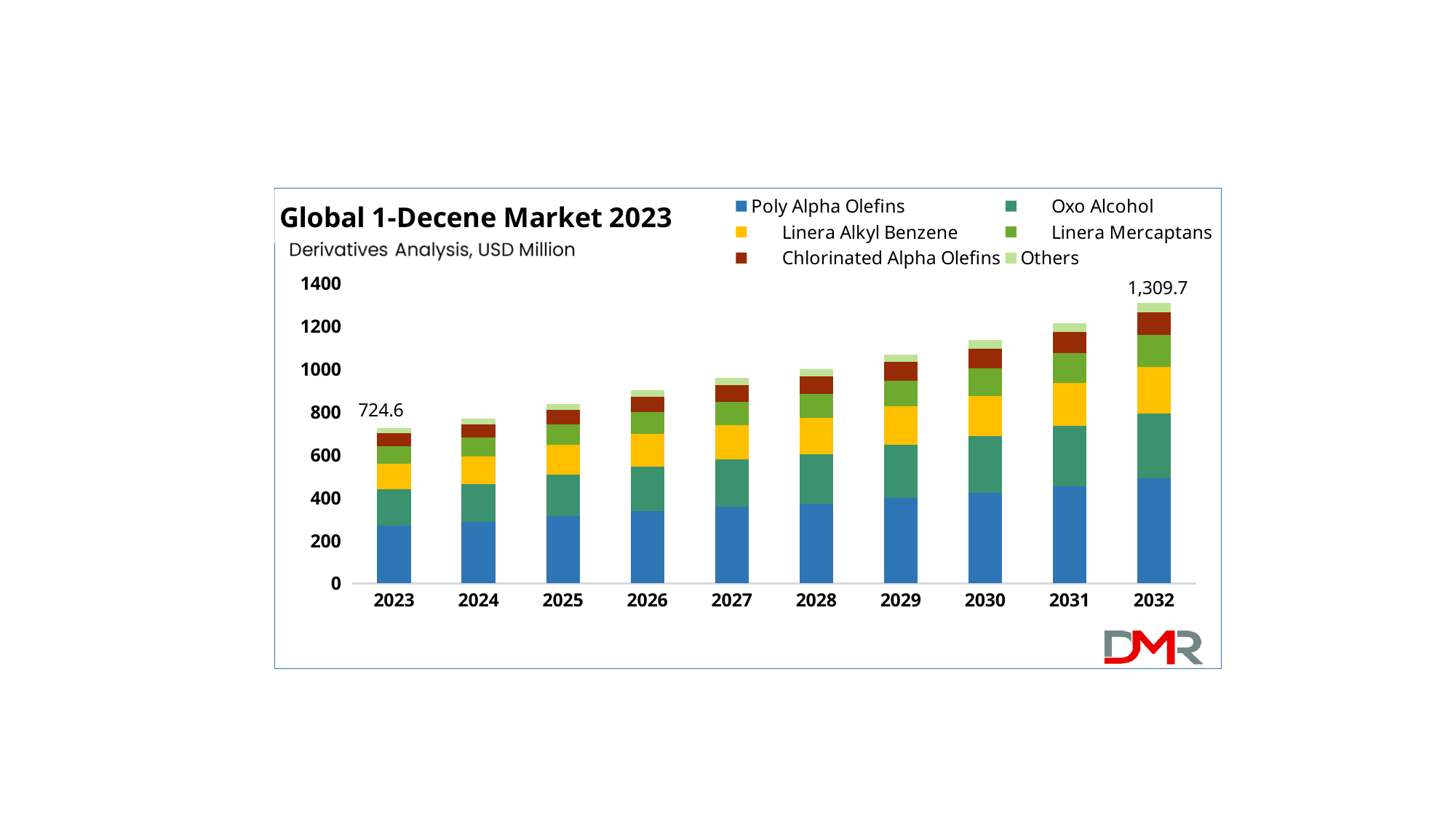
Is the total value for 2030 greater or less than 1000? greater How many years are shown along the x axis of the chart? 10 Which year has the highest total bar? 2032 What kind of chart is shown on the slide? bar chart Is the total value for 2027 greater or less than 1000? less Which year has the lowest total bar? 2023 What is the total market value labelled for 2032? 1,309.7 How many series does the chart's legend list? 6 What is the difference between the labelled totals for 2032 and 2023? 585.1 What is the total market value labelled for 2023? 724.6 What unit is stated in the chart's subtitle? USD Million Do the stacked bar totals rise or fall from 2023 to 2032? rise